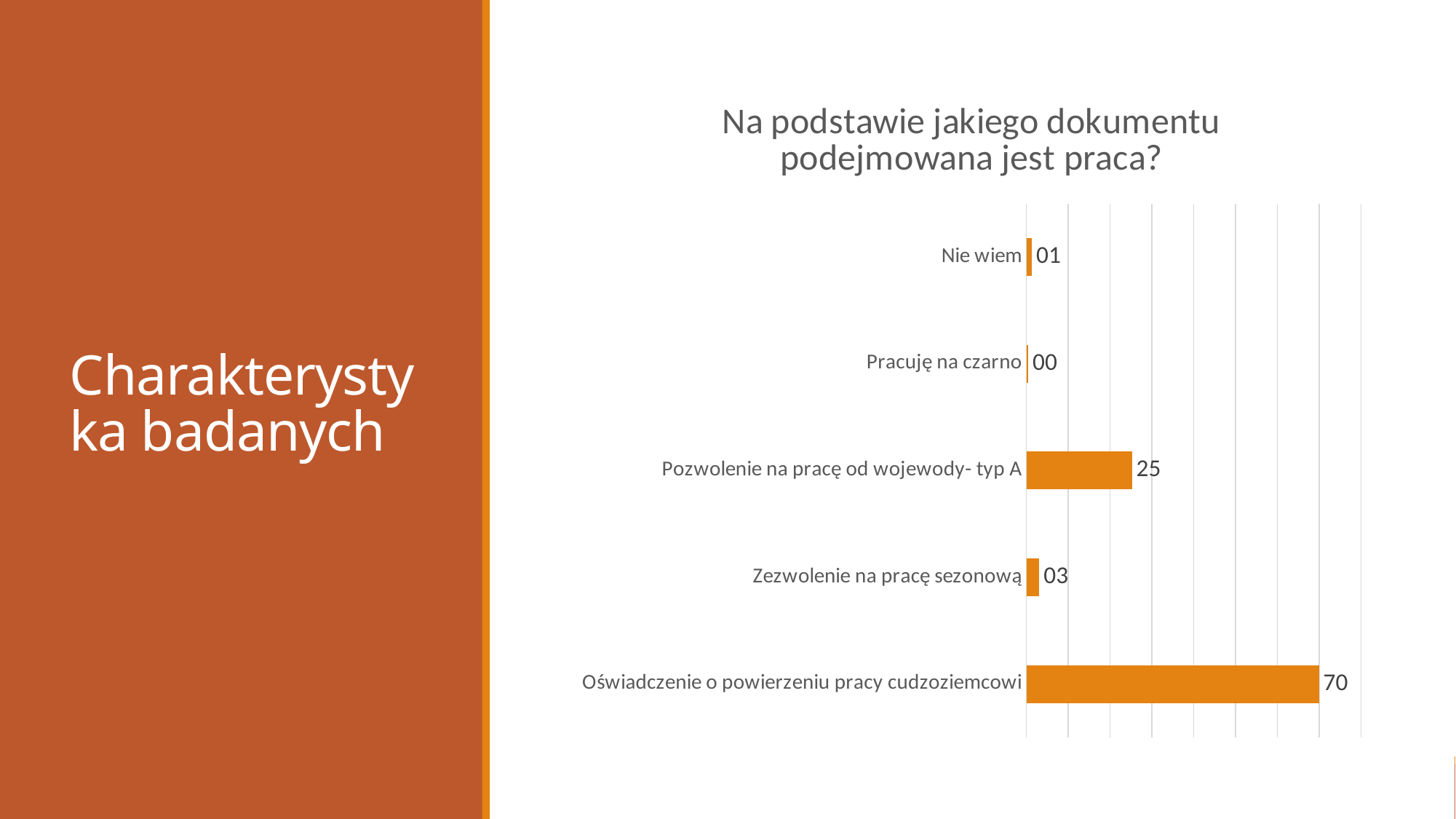
What is the title of the chart? Na podstawie jakiego dokumentu podejmowana jest praca? What is the difference between the values for "Oświadczenie o powierzeniu pracy cudzoziemcowi" and "Pozwolenie na pracę od wojewody- typ A"? 45 What is the value for "Zezwolenie na pracę sezonową"? 03 How many categories are shown in the chart? 5 What is the value for "Oświadczenie o powierzeniu pracy cudzoziemcowi"? 70 What is the value for "Nie wiem"? 01 What is the value for "Pozwolenie na pracę od wojewody- typ A"? 25 Which is larger: the value for "Zezwolenie na pracę sezonową" or the value for "Nie wiem"? Zezwolenie na pracę sezonową What kind of chart is shown on the slide? Bar chart Which category has the highest value? Oświadczenie o powierzeniu pracy cudzoziemcowi What is the value for "Pracuję na czarno"? 00 Which category has the lowest value? Pracuję na czarno